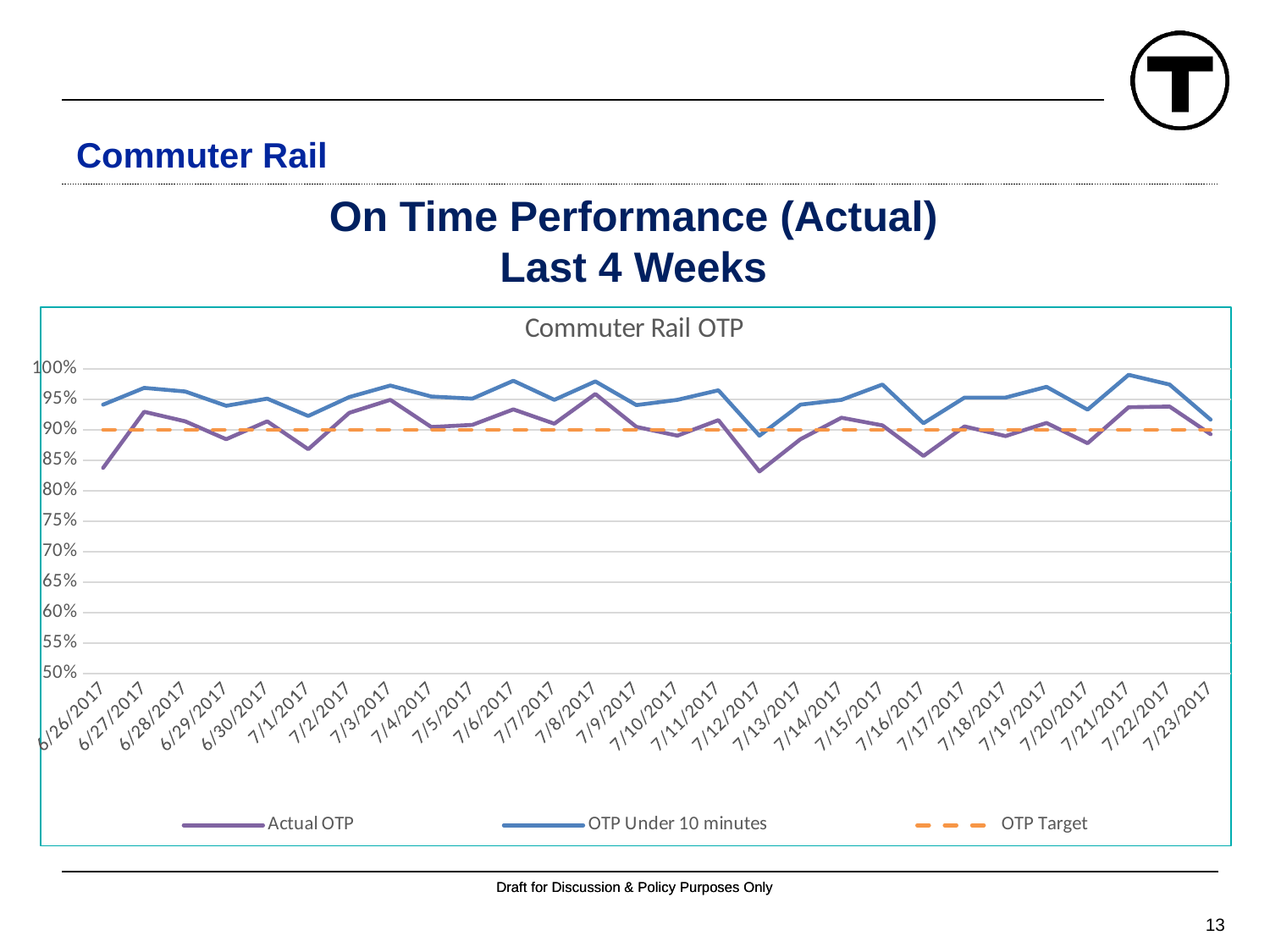
Is the Actual OTP value for 7/8/2017 greater or less than 90%? greater What is the title shown inside the chart area? Commuter Rail OTP Which is higher for Actual OTP: 7/12/2017 or 7/21/2017? 7/21/2017 Is the Actual OTP value for 6/26/2017 greater or less than 90%? less How many series does the chart legend list? 3 Is the Actual OTP value for 7/12/2017 greater or less than 90%? less On 6/26/2017, which is higher: Actual OTP or OTP Under 10 minutes? OTP Under 10 minutes What kind of chart is shown on the slide? line chart What is the value of the OTP Target line on 7/10/2017? 90% How many dates are plotted along the x axis of the chart? 28 Does the Actual OTP line rise or fall from 7/12/2017 to 7/15/2017? rise